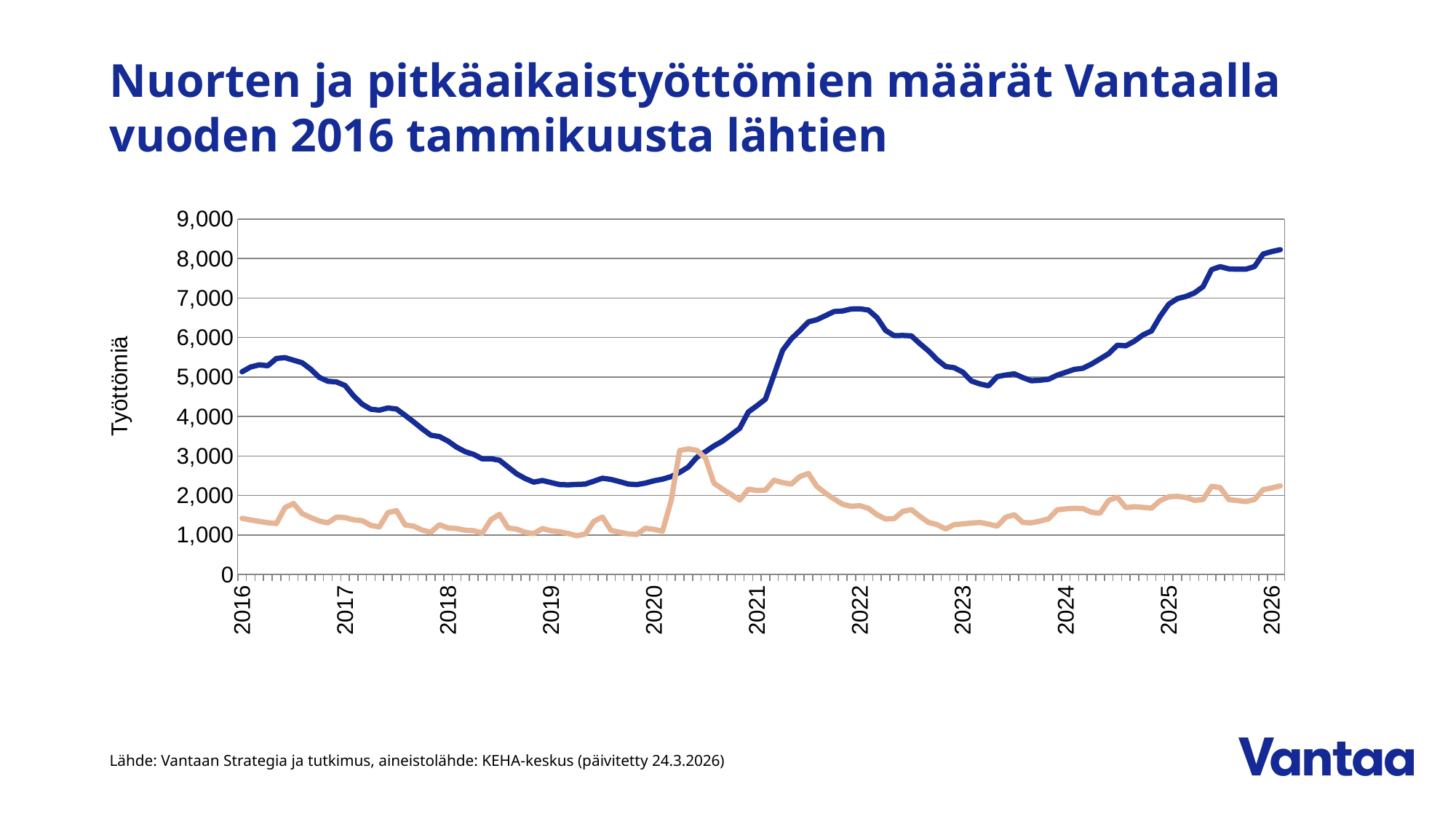
How many lines are plotted on the chart? 2 Does the dark blue line rise or fall between 2016 and 2019? fall Which line is higher at the start of 2022, the dark blue line or the light orange line? dark blue line Is the value of the light orange line at the start of 2016 greater or less than 2,000? less What is the highest value shown on the y axis? 9,000 Is the peak of the light orange line in 2020 greater or less than 2,000? greater Is the value of the dark blue line at the start of 2019 greater or less than 3,000? less How many year labels are shown on the x axis? 11 What is the label of the y axis? Työttömiä What kind of chart is shown on the slide? line chart